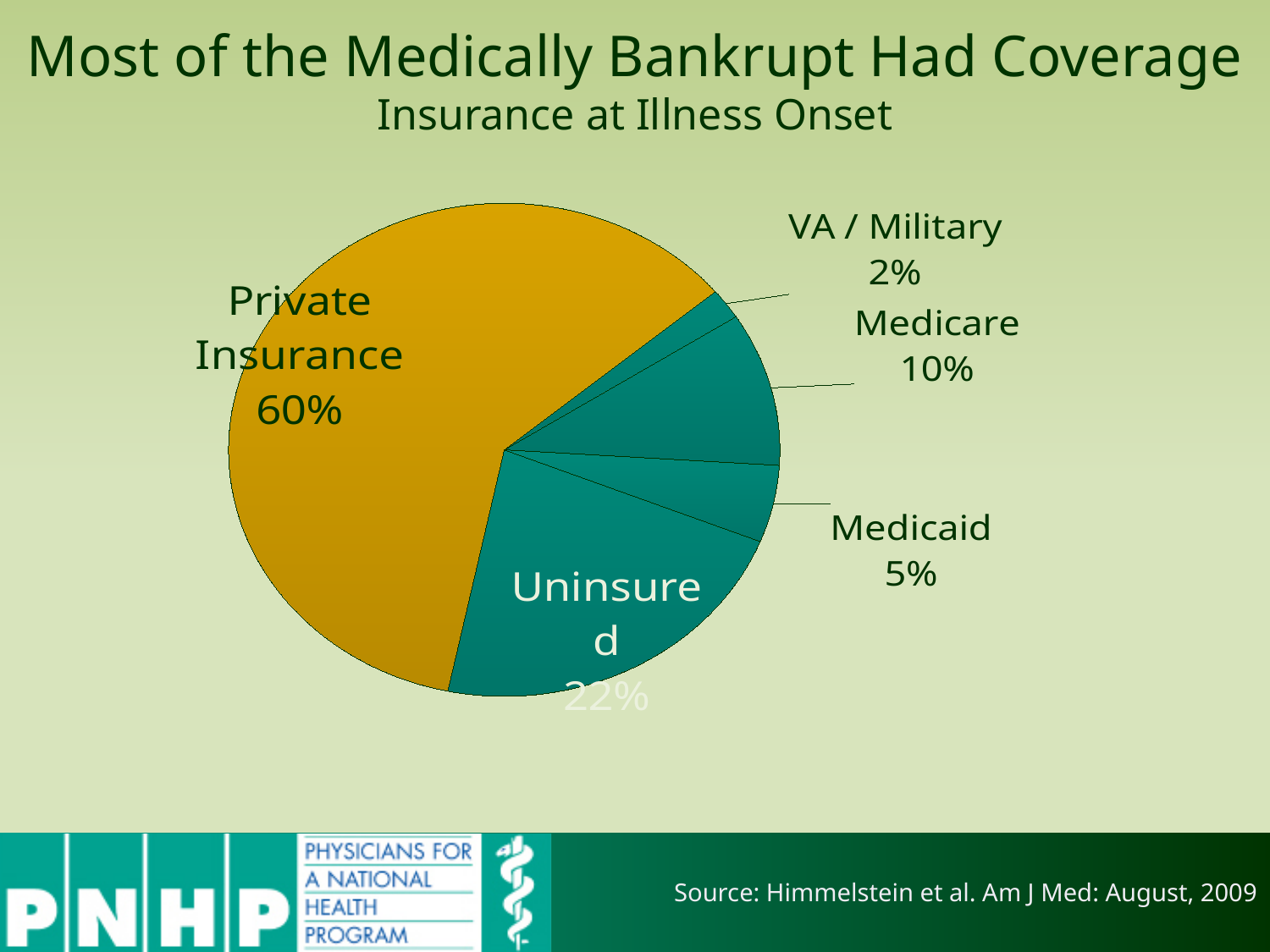
What share of the pie is Medicaid? 5% What share of the pie is VA / Military? 2% What share of the pie is Medicare? 10% Which category has the largest slice of the pie? Private Insurance What kind of chart is shown on the slide? pie chart Which is larger, the Medicare slice or the Medicaid slice? Medicare What is the subtitle of the chart on the slide? Insurance at Illness Onset Which category has the smallest slice of the pie? VA / Military How many slices does the pie chart have? 5 What is the difference in percentage points between Private Insurance and Uninsured? 38